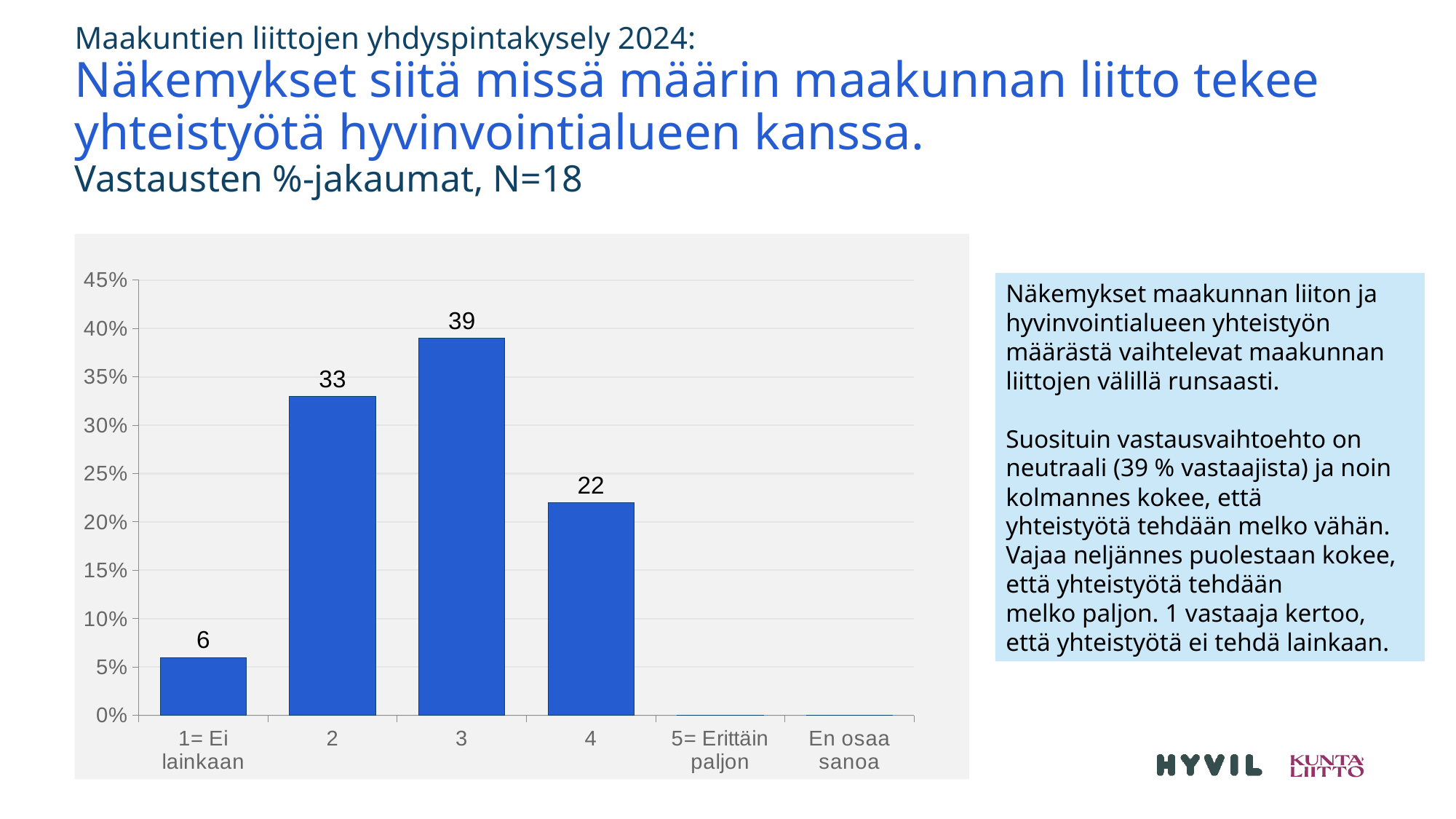
What value is shown for category 2? 33 Which category has the highest value? 3 What value is shown for the category '1= Ei lainkaan'? 6 How many categories are shown on the x axis? 6 What value is shown for category 3? 39 What value is shown for category 4? 22 What kind of chart is shown on the slide? bar chart Which is larger, the value for category 2 or the value for category 4? 2 What is the difference between the values for category 3 and category 2? 6 Which of the labelled bars has the lowest value? 1= Ei lainkaan Is the value for category 4 greater or less than 25%? less What is the N value stated in the subtitle of the slide? N=18